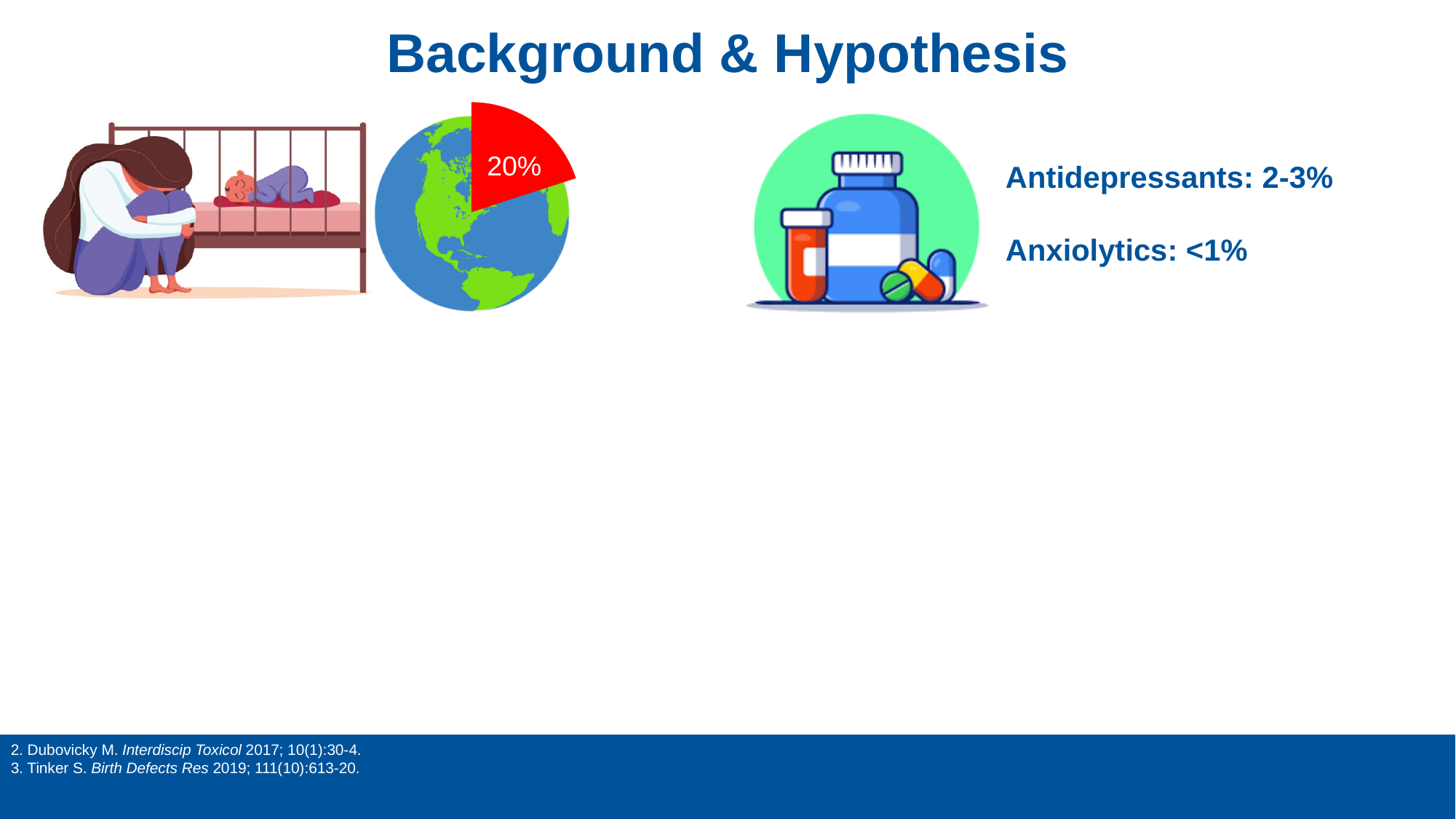
What percentage is printed on the red slice over the globe? 20% Is the value shown on the globe slice greater or less than 50%? less What kind of chart is overlaid on the globe image? pie chart What colour is the highlighted slice on the globe chart? red What share of the globe pie does the red slice represent? 20%